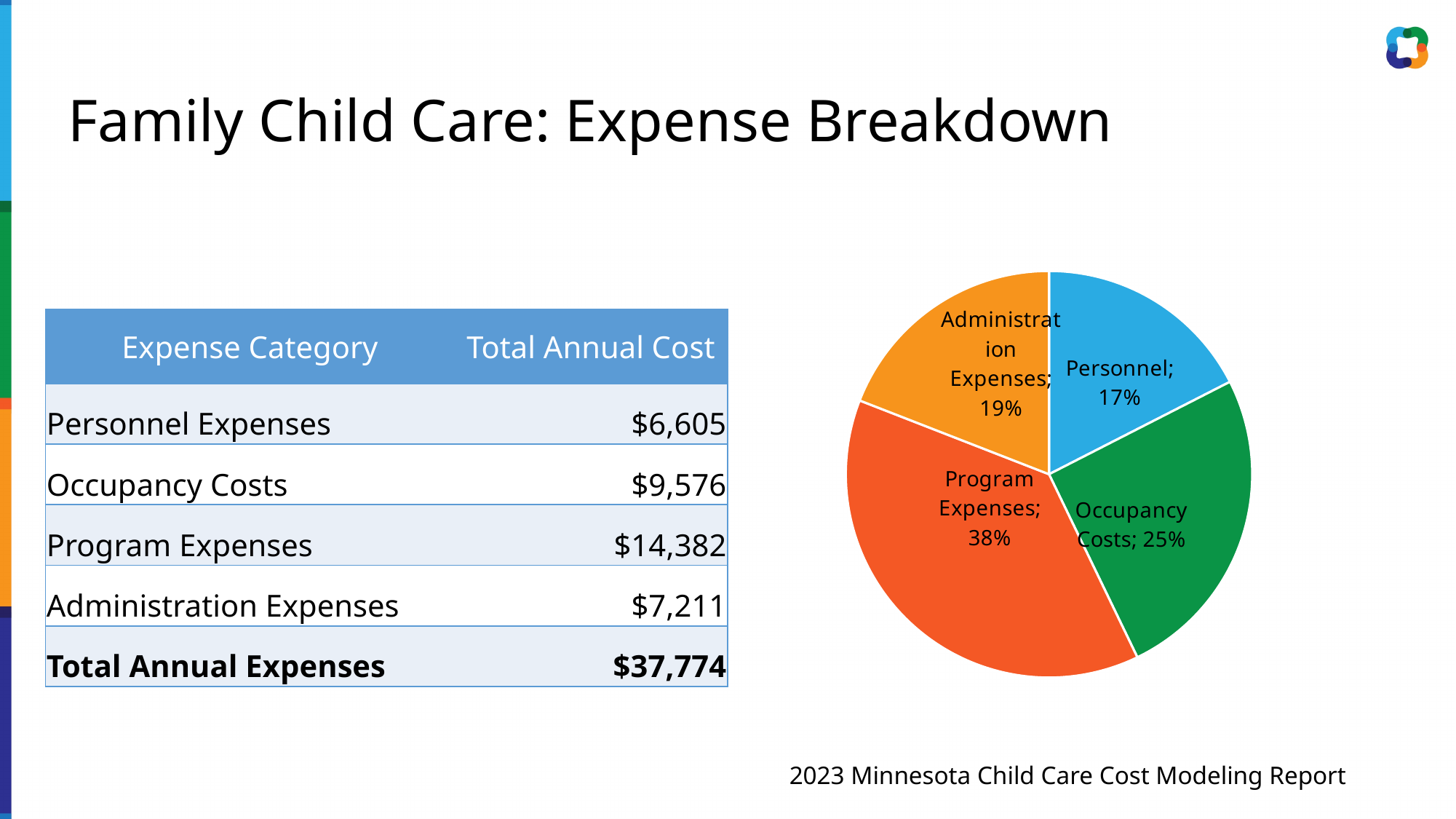
Which slice of the pie chart is the largest? Program Expenses What colour is the Occupancy Costs slice in the pie chart? Green Which slice of the pie chart is the smallest? Personnel Which is larger in the pie chart, Occupancy Costs or Administration Expenses? Occupancy Costs What share of the pie does Program Expenses represent? 38% What kind of chart is shown on the slide? Pie chart What share of the pie does Administration Expenses represent? 19% What share of the pie does Personnel represent? 17% How many slices does the pie chart have? 4 What colour is the Program Expenses slice in the pie chart? Red-orange What is the difference in percentage points between the Program Expenses slice and the Personnel slice? 21 percentage points